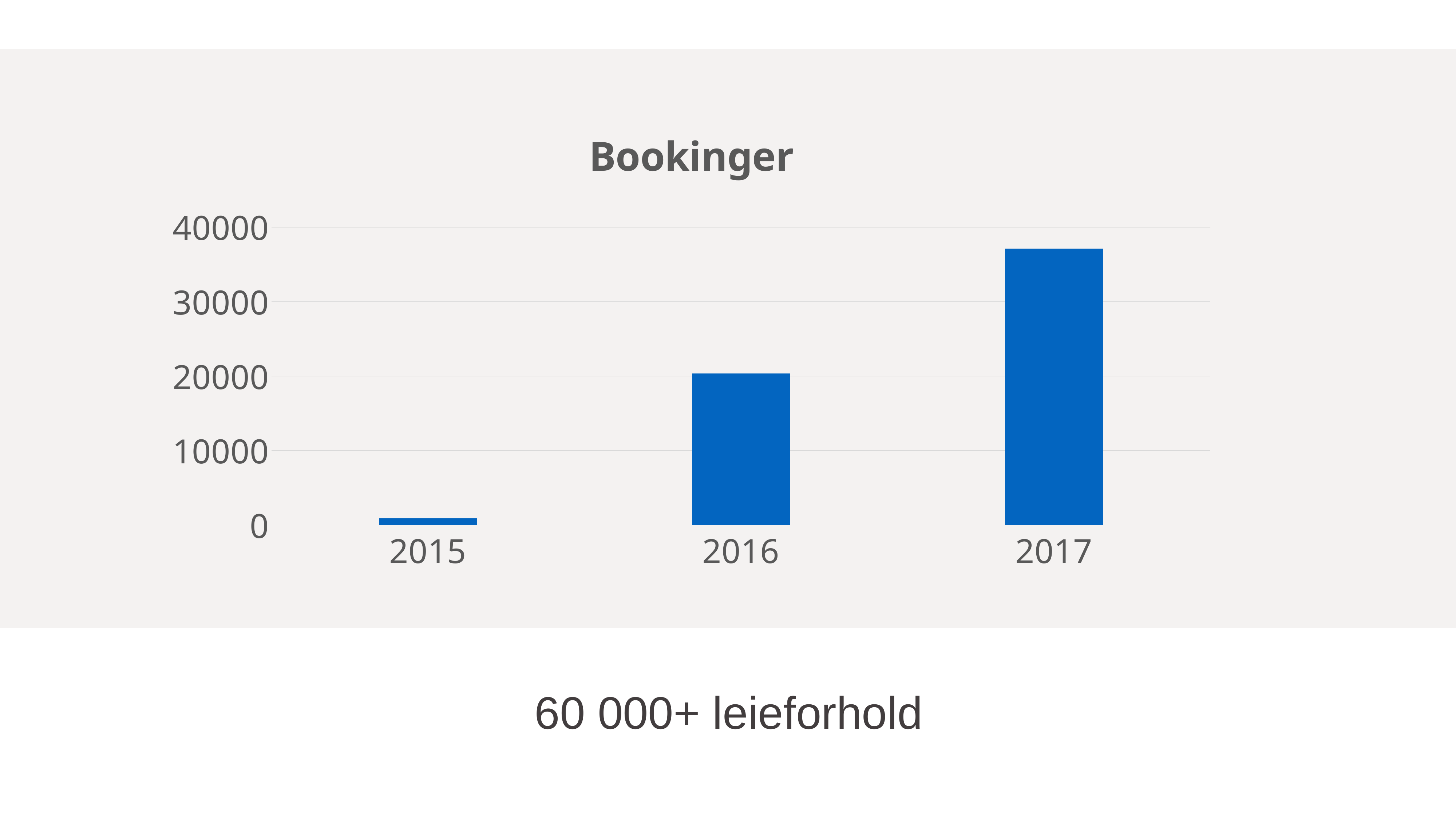
Is the value for 2016 greater or less than 30000? less How many years are shown on the x axis of the chart? 3 What is the highest value shown on the y axis? 40000 Is the value for 2015 greater or less than 10000? less What is the title of the chart? Bookinger Do the values rise or fall from 2015 to 2017? rise Is the value for 2017 greater or less than 40000? less Which year has the lowest number of bookings? 2015 Which year has the highest number of bookings? 2017 Which is larger, the value for 2016 or the value for 2017? 2017 What kind of chart is shown on the slide? bar chart